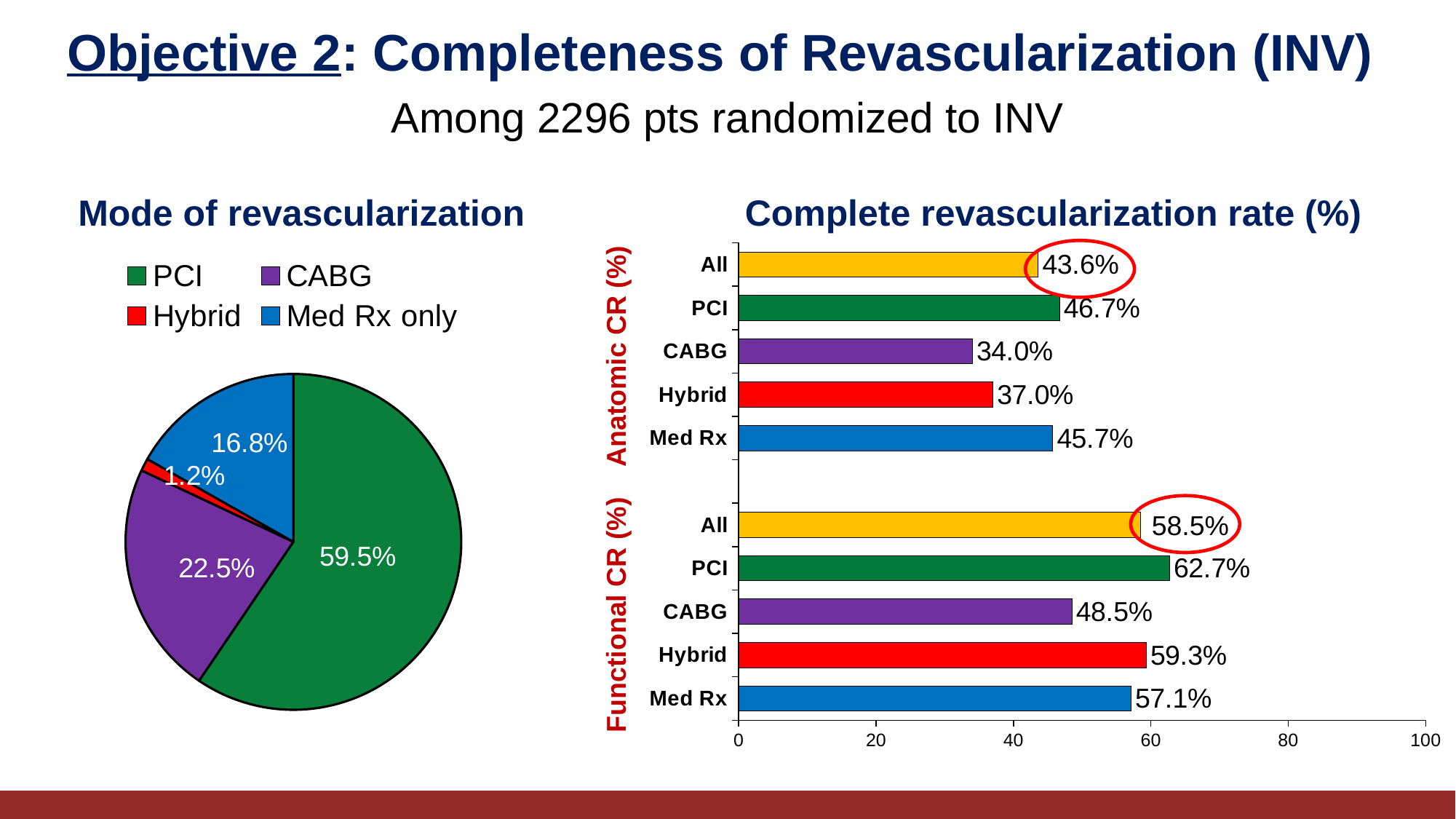
In the 'Complete revascularization rate (%)' chart, which is larger: the Anatomic CR rate for Hybrid or for Med Rx? Med Rx In the 'Complete revascularization rate (%)' chart, what is the difference between the Functional CR rate and the Anatomic CR rate for All patients? 14.9% What kind of chart is 'Complete revascularization rate (%)'? Bar chart In the 'Complete revascularization rate (%)' chart, which group has the highest Functional CR rate? PCI In the 'Mode of revascularization' pie chart, how many slices are there? 4 In the 'Complete revascularization rate (%)' chart, which group has the lowest Anatomic CR rate? CABG In the 'Complete revascularization rate (%)' chart, what is the Functional CR rate for All patients? 58.5% In the 'Complete revascularization rate (%)' chart, what is the Anatomic CR rate for CABG? 34.0% In the 'Mode of revascularization' pie chart, what share of patients had CABG? 22.5% In the 'Mode of revascularization' pie chart, which mode has the smallest slice? Hybrid What kind of chart is 'Mode of revascularization'? Pie chart In the 'Mode of revascularization' pie chart, what share of patients had PCI? 59.5%